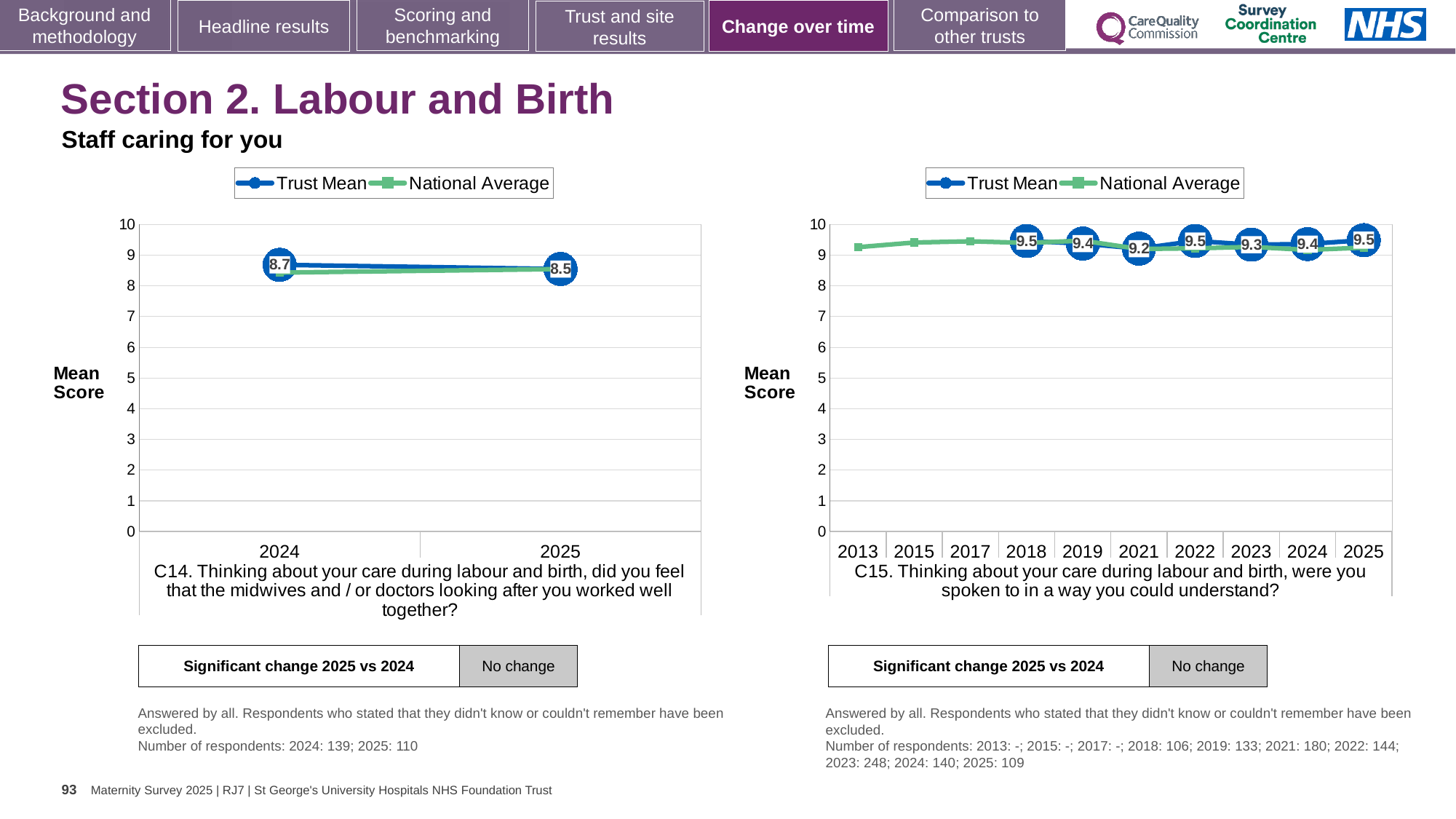
How many series does the legend of the left chart list? 2 In the right chart (C15), what is the Trust Mean for 2025? 9.5 In the right chart (C15), is the Trust Mean higher in 2022 or in 2023? 2022 In the right chart (C15), which year has the lowest Trust Mean? 2021 In the left chart (C14), what is the Trust Mean for 2025? 8.5 What type of chart is the right chart (C15)? line chart In the right chart (C15), what is the Trust Mean for 2021? 9.2 In the left chart (C14), by how much did the Trust Mean change from 2024 to 2025? 0.2 In the left chart (C14), what is the Trust Mean for 2024? 8.7 In the left chart (C14), does the Trust Mean rise or fall from 2024 to 2025? fall In the right chart (C15), how many years are shown on the x axis? 10 In the right chart (C15), what is the difference between the Trust Mean in 2025 and in 2021? 0.3